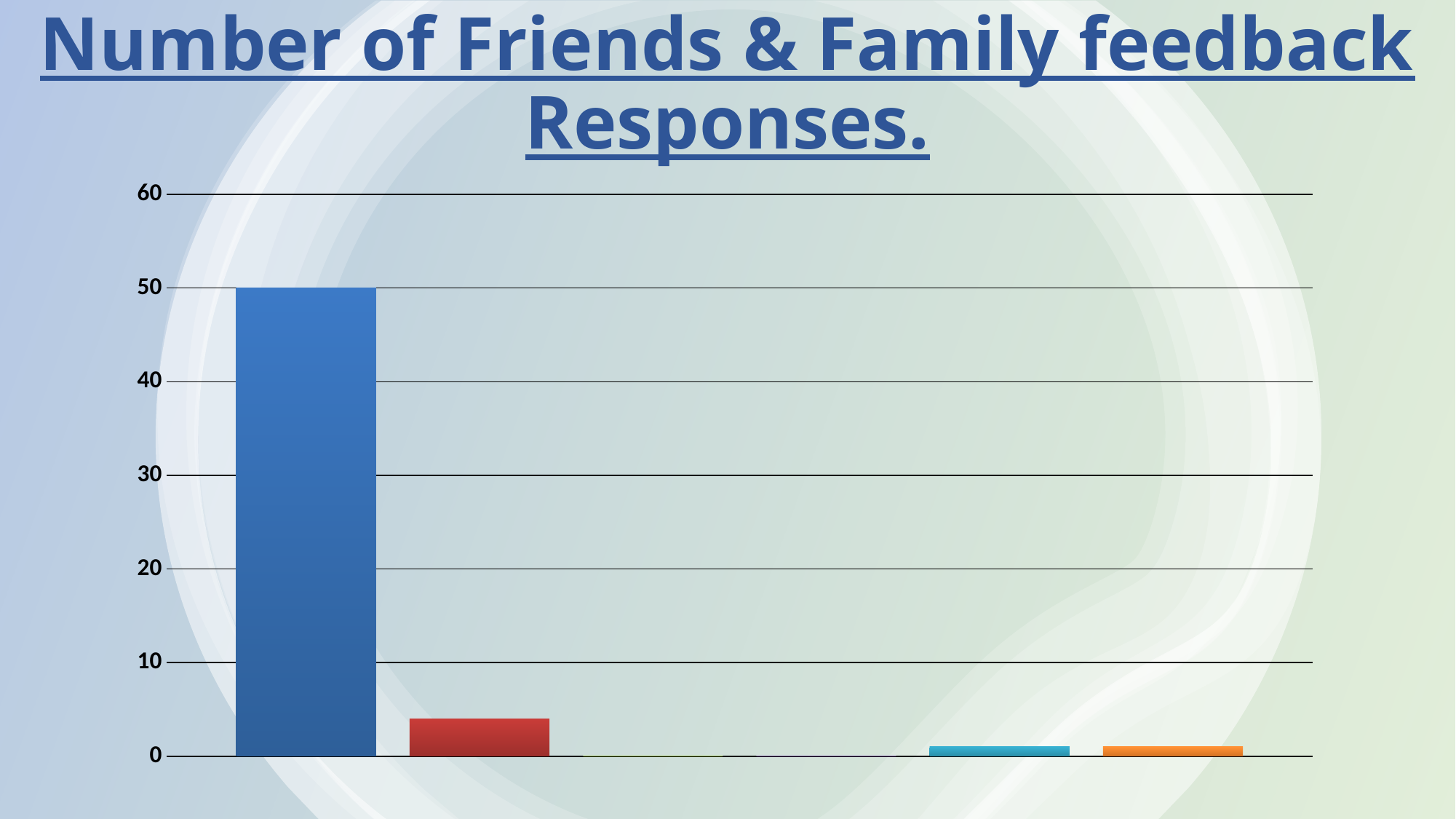
Is the value of the blue bar greater or less than 40? greater What type of chart is shown on the slide? bar chart Is the value of the orange bar (rightmost) greater or less than 10? less Is the value of the red bar greater or less than 10? less Which is larger, the red bar or the teal bar? the red bar What is the highest value shown on the vertical axis? 60 Which is larger, the blue bar or the red bar? the blue bar Which bar has the highest value? the blue bar (first from the left) What is the title of the chart on the slide? Number of Friends & Family feedback Responses. What value does the tallest (blue) bar reach on the vertical axis? 50